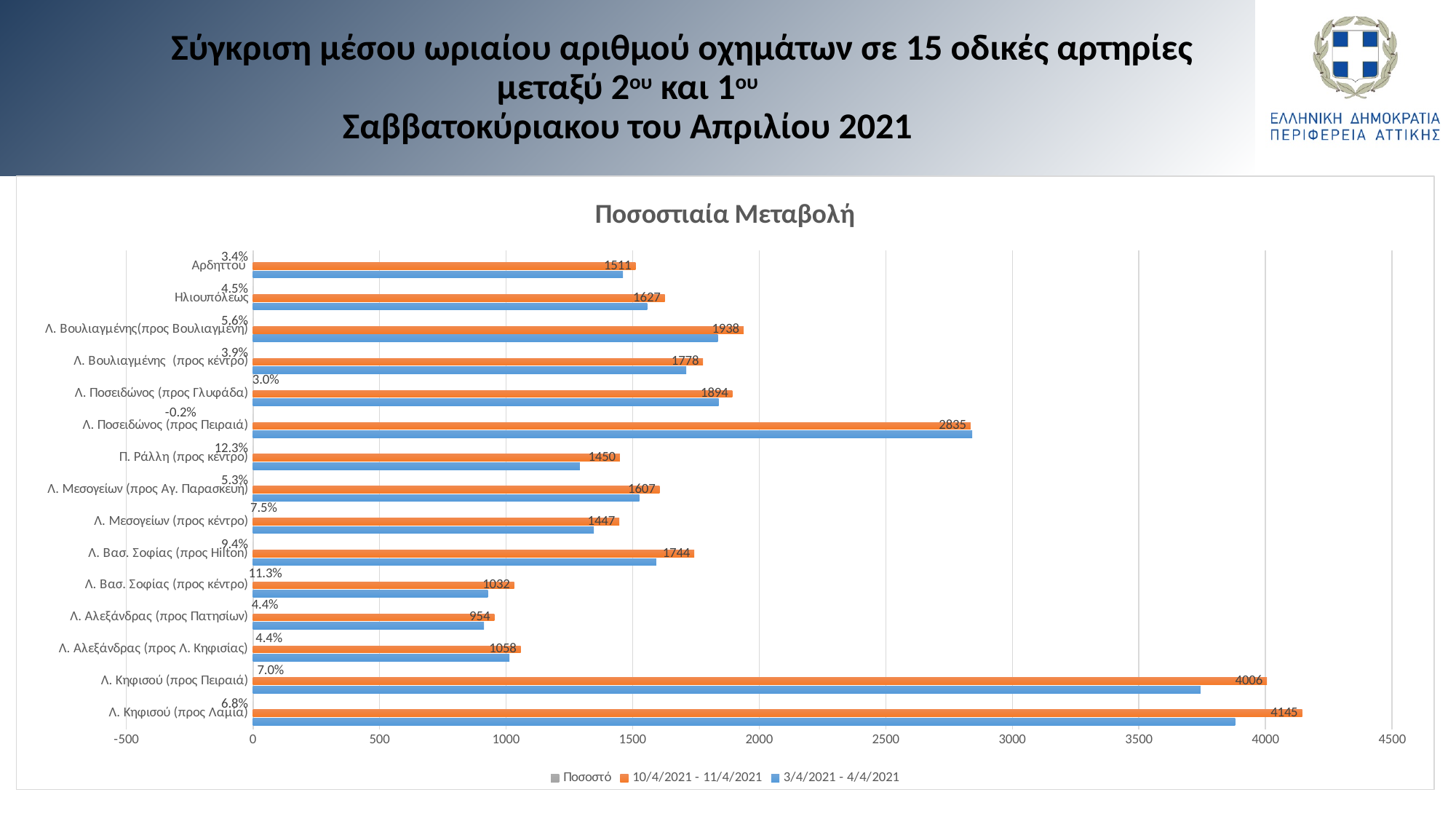
Which road has the lowest Ποσοστό value? Λ. Ποσειδώνος (προς Πειραιά) How many series does the legend list? 3 How many roads are listed on the chart? 15 In the 10/4/2021 - 11/4/2021 series, which is larger: Λ. Βασ. Σοφίας (προς Hilton) or Λ. Βουλιαγμένης (προς κέντρο)? Λ. Βουλιαγμένης (προς κέντρο) What is the value for Αρδηττού in the 10/4/2021 - 11/4/2021 series? 1511 What is the value for Λ. Κηφισού (προς Λαμία) in the 10/4/2021 - 11/4/2021 series? 4145 Which road has the highest value in the 10/4/2021 - 11/4/2021 series? Λ. Κηφισού (προς Λαμία) What is the Ποσοστό value shown for Π. Ράλλη (προς κέντρο)? 12.3% Is the 3/4/2021 - 4/4/2021 value for Λ. Ποσειδώνος (προς Πειραιά) greater or less than 2500? greater Which road has the lowest value in the 10/4/2021 - 11/4/2021 series? Λ. Αλεξάνδρας (προς Πατησίων) What type of chart is shown on the slide? bar chart What is the difference between the 10/4/2021 - 11/4/2021 values for Λ. Κηφισού (προς Λαμία) and Λ. Κηφισού (προς Πειραιά)? 139